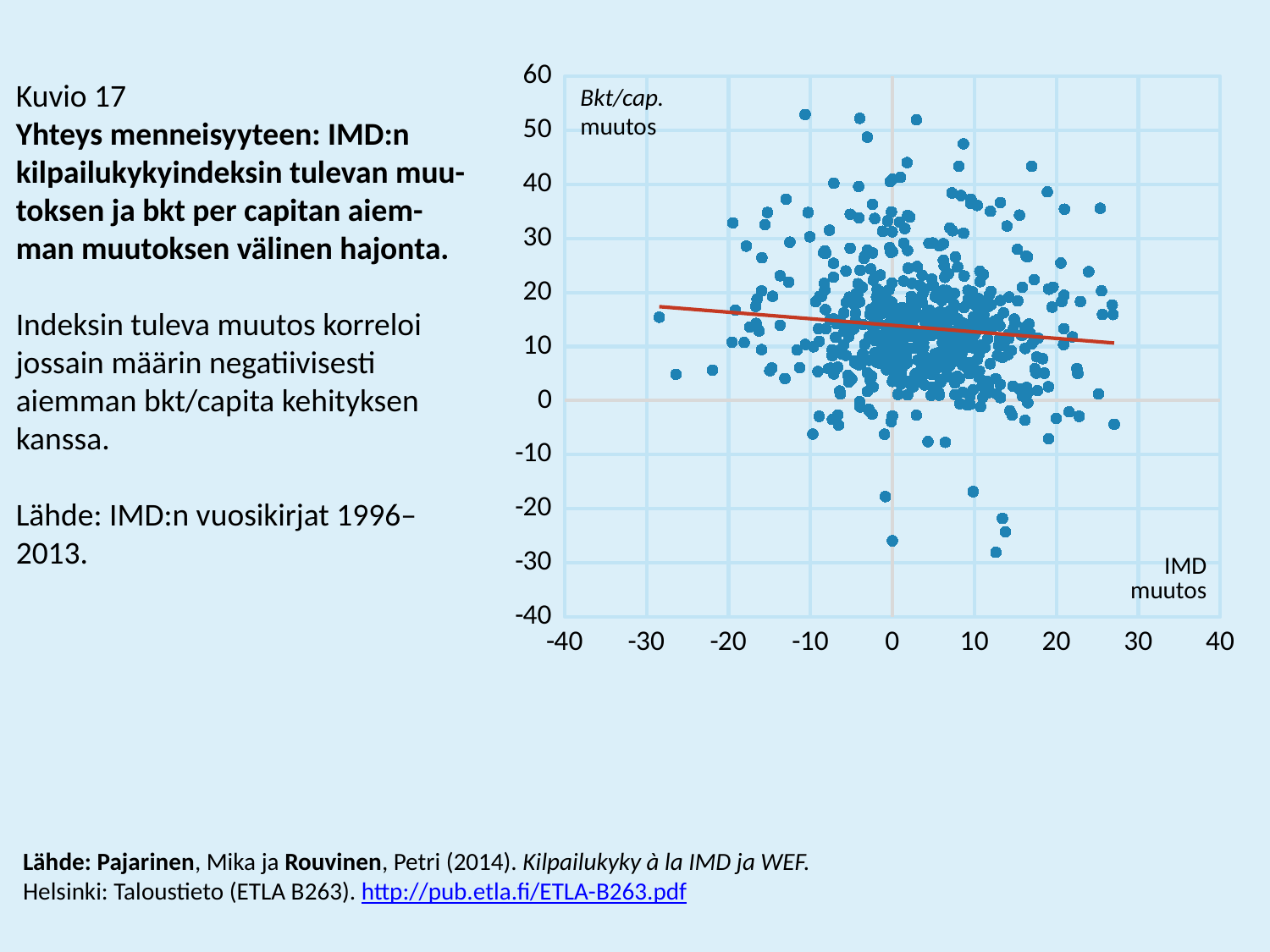
Does the fitted trend line rise or fall as the IMD muutos value increases along the x axis? falls What label is given to the vertical axis of the chart? Bkt/cap. muutos Is the value of the trend line at IMD muutos = -30 greater or less than 10? greater What kind of chart is shown on the slide? scatter plot What label is given to the horizontal axis of the chart? IMD muutos Is the value of the trend line at IMD muutos = -30 greater or less than 30? less Is the lowest plotted point's Bkt/cap. muutos value greater or less than -20? less